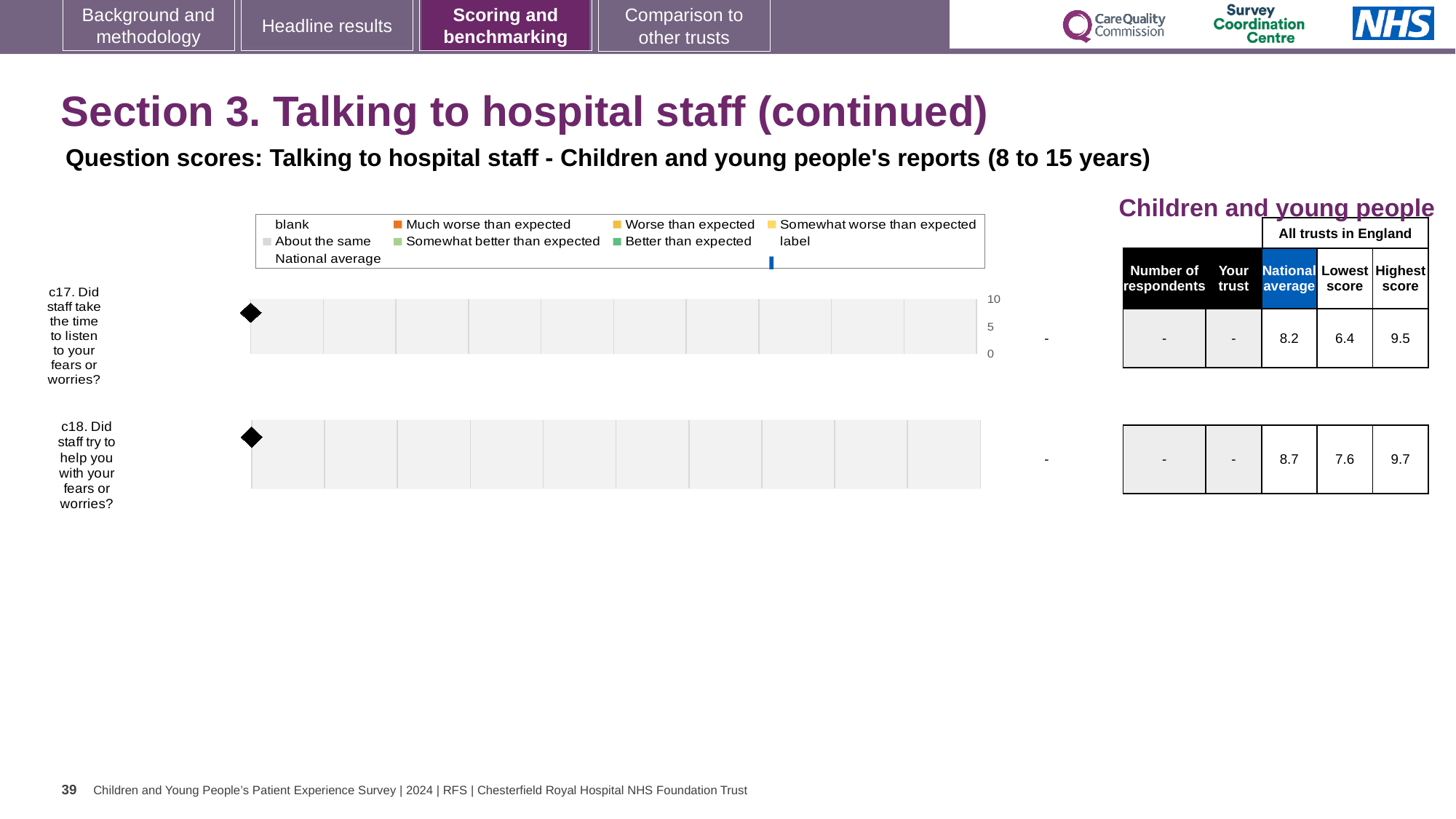
In the table beside the c18 chart, what is the highest score among all trusts in England for c18? 9.7 What is the highest value shown on the score axis of the c17 chart? 10 In the table beside the c17 chart, what is the lowest score among all trusts in England for c17? 6.4 What is the lowest value shown on the score axis of the c17 chart? 0 What is the difference between the highest score and the lowest score for c17 in the table? 3.1 What kind of chart is used for the c17 and c18 question scores? bar chart In the table beside the c17 chart, what is the national average score for c17? 8.2 How many survey questions (categories) are shown in the charts on this slide? 2 Is the national average for c18 greater or less than 5 on the chart's score axis? greater Which question has the higher national average, c17 or c18? c18 What is the difference between the highest score and the lowest score for c18 in the table? 2.1 In the table beside the c18 chart, what is the national average score for c18? 8.7